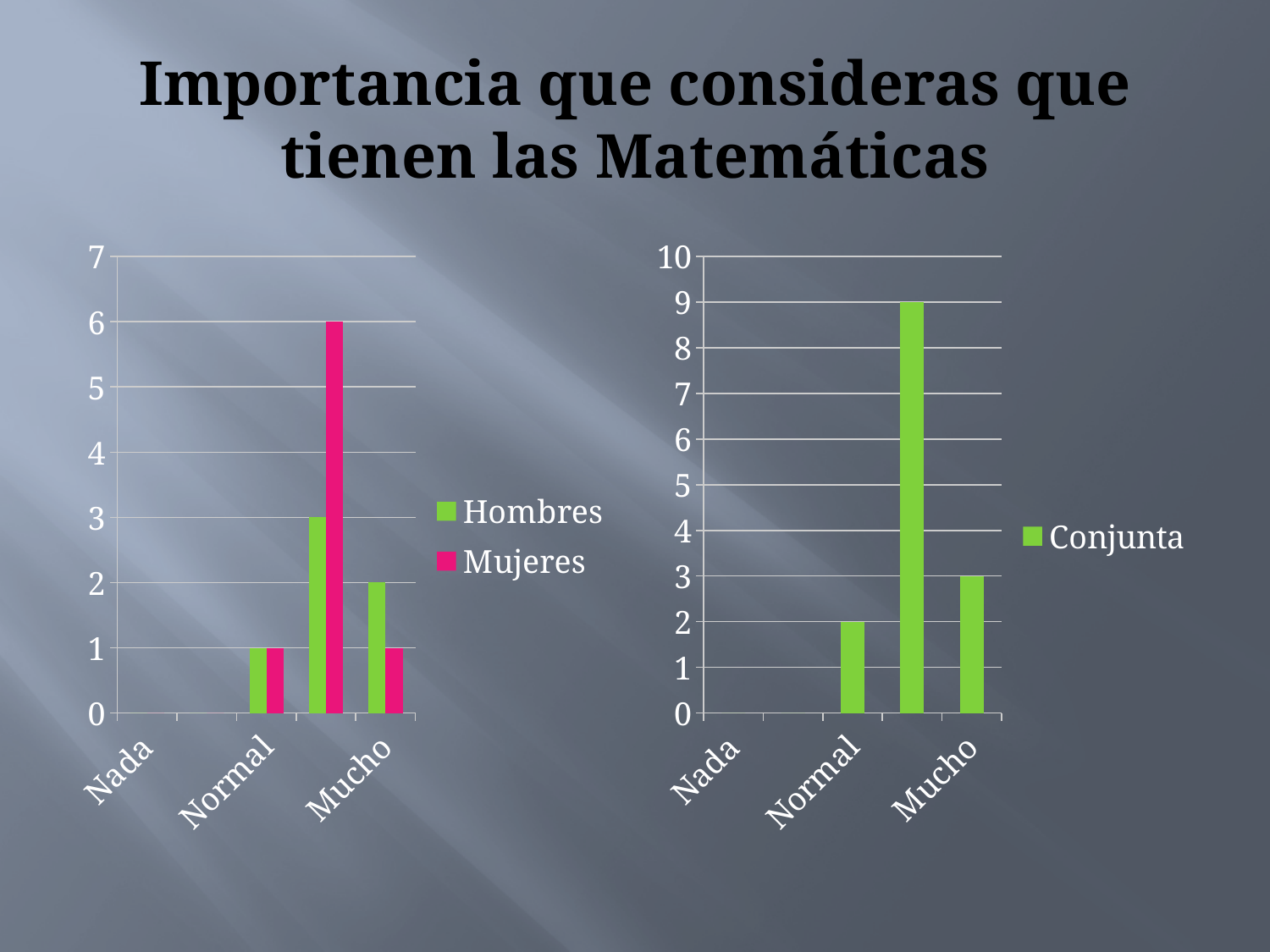
What kind of chart is the left chart (Hombres/Mujeres)? bar chart In the left chart, what is the Hombres value for Mucho? 2 In the left chart, what is the Mujeres value for Mucho? 1 How many series does the legend of the right chart list? 1 In the right chart (Conjunta), what is the value for Mucho? 3 In the right chart (Conjunta), what is the value for Normal? 2 What are the two legend entries of the left chart? Hombres and Mujeres In the left chart, which series has the larger value for Mucho, Hombres or Mujeres? Hombres In the left chart, what is the Hombres value for Normal? 1 How many series does the legend of the left chart list? 2 In the left chart, what is the difference between the Hombres and Mujeres values for Mucho? 1 In the right chart (Conjunta), is the tallest bar greater or less than 8? greater